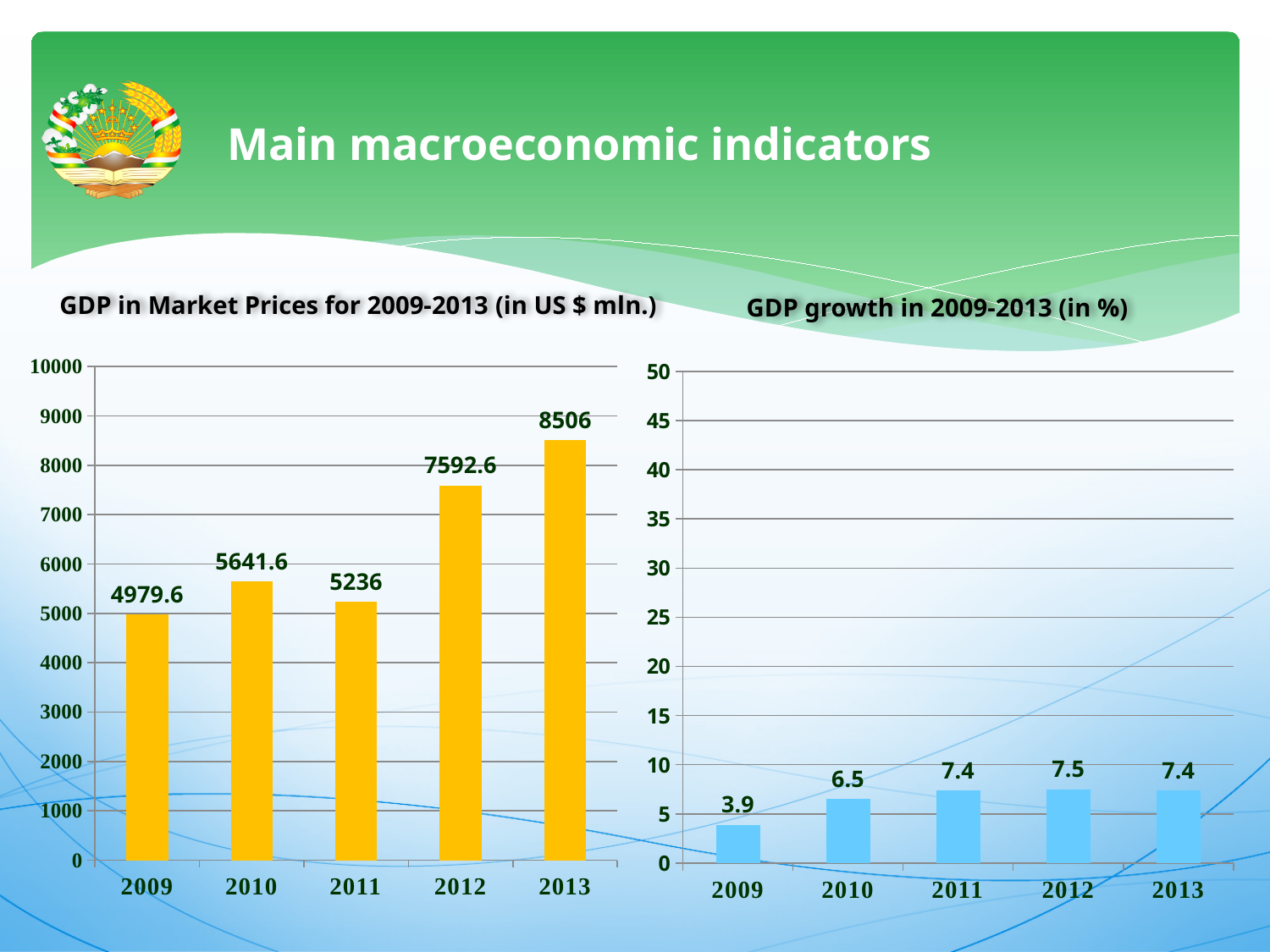
In the 'GDP in Market Prices for 2009-2013 (in US $ mln.)' chart, how many years are shown? 5 In the 'GDP growth in 2009-2013 (in %)' chart, what is the difference between the values for 2010 and 2009? 2.6 In the 'GDP growth in 2009-2013 (in %)' chart, is the value for 2013 greater or less than 10? less In the 'GDP in Market Prices for 2009-2013 (in US $ mln.)' chart, what is the difference between the values for 2013 and 2012? 913.4 In the 'GDP in Market Prices for 2009-2013 (in US $ mln.)' chart, which is larger, the value for 2010 or the value for 2011? 2010 In the 'GDP growth in 2009-2013 (in %)' chart, what is the value for 2009? 3.9 What is the title of the chart on the left of the slide? GDP in Market Prices for 2009-2013 (in US $ mln.) In the 'GDP in Market Prices for 2009-2013 (in US $ mln.)' chart, which year has the lowest value? 2009 In the 'GDP in Market Prices for 2009-2013 (in US $ mln.)' chart, what is the value for 2011? 5236 In the 'GDP in Market Prices for 2009-2013 (in US $ mln.)' chart, which year has the highest value? 2013 What kind of chart is the 'GDP growth in 2009-2013 (in %)' chart? bar chart In the 'GDP growth in 2009-2013 (in %)' chart, which year has the highest value? 2012